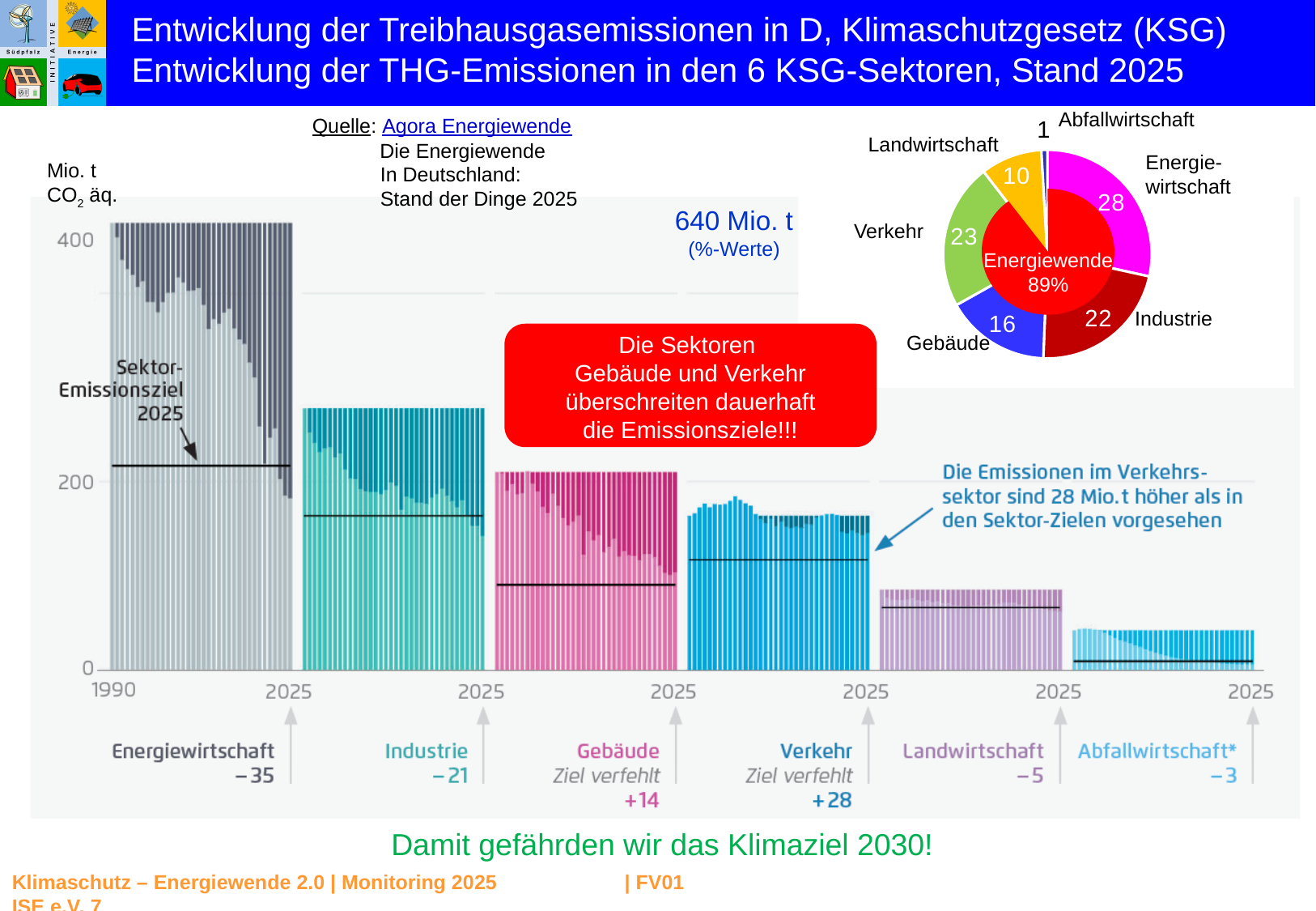
In the pie chart at the top right, how many sectors are shown as slices? 6 In the pie chart at the top right, what percentage share is shown for Energiewirtschaft? 28 In the pie chart at the top right, what is the difference between the shares of Verkehr and Gebäude? 7 In the large bar chart, are the emissions of the Verkehr sector greater or less than 200 Mio. t? less In the large bar chart, by how many Mio. t does the Verkehr sector miss its 2025 target according to the label below the chart? +28 In the pie chart at the top right, which has the larger share, Industrie or Verkehr? Verkehr In the large bar chart, what value is printed below the Gebäude sector? +14 In the pie chart at the top right, what total amount in Mio. t is stated next to the chart? 640 Mio. t In the pie chart at the top right, which sector has the largest share? Energiewirtschaft In the pie chart at the top right, which sector has the smallest share? Abfallwirtschaft What kind of chart is the large chart showing sector emissions from 1990 to 2025? bar chart In the large bar chart, do the emissions of the Energiewirtschaft sector rise or fall from 1990 to 2025? fall